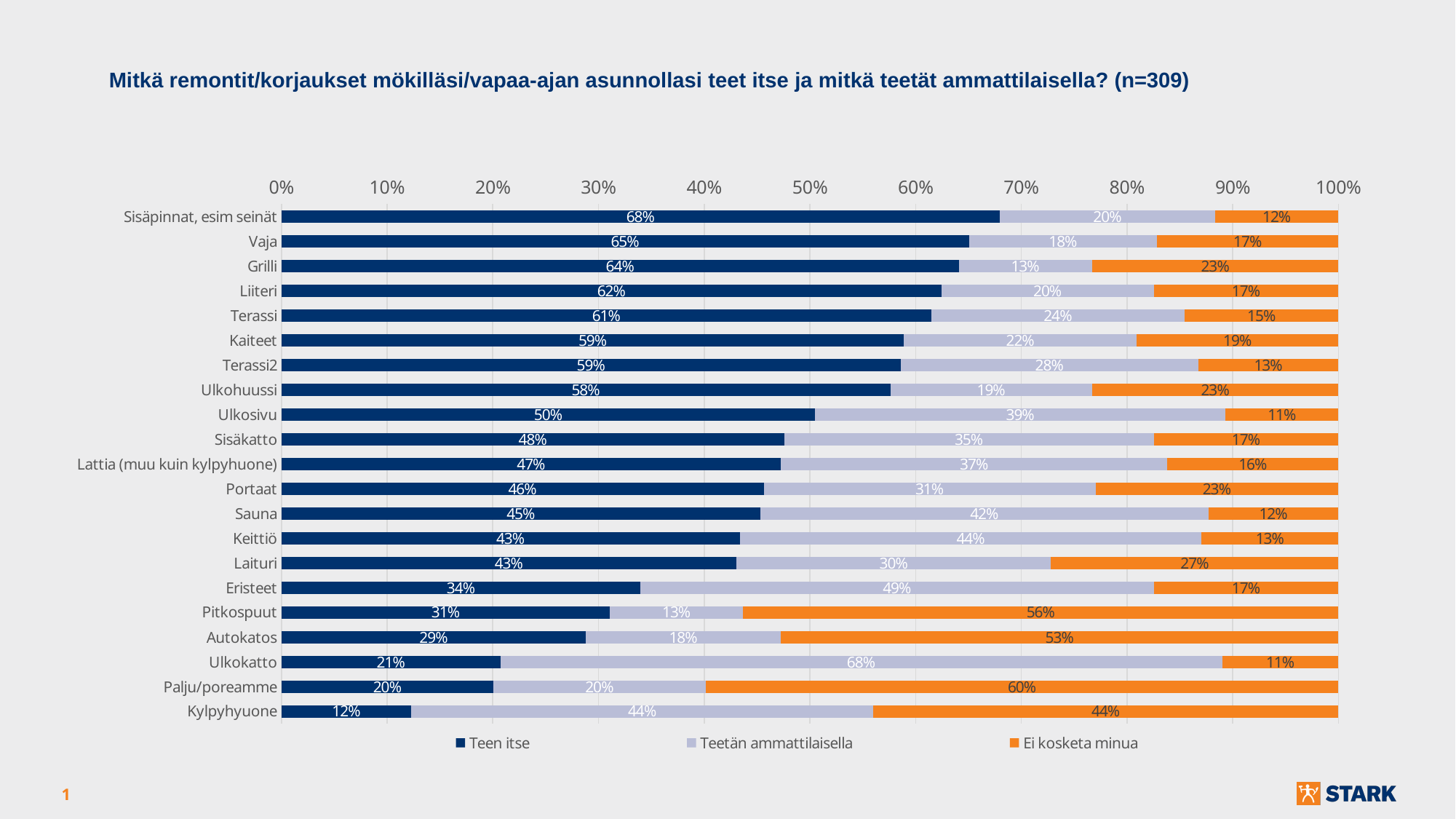
What kind of chart is shown on the slide? Stacked bar chart Is the 'Teen itse' value for Eristeet greater or less than 40%? less What is the 'Teetän ammattilaisella' value for Ulkokatto? 68% Which category has the highest 'Teen itse' value? Sisäpinnat, esim seinät What is the 'Ei kosketa minua' value for Palju/poreamme? 60% Which series is shown in orange in the legend? Ei kosketa minua How many categories are shown on the chart? 21 What is the difference between the 'Teen itse' values for Vaja and Autokatos? 36% What is the 'Teen itse' value for Sisäpinnat, esim seinät? 68% Which category has the lowest 'Teen itse' value? Kylpyhyuone How many series does the legend list? 3 Which is larger: the 'Ei kosketa minua' value for Pitkospuut or for Laituri? Pitkospuut